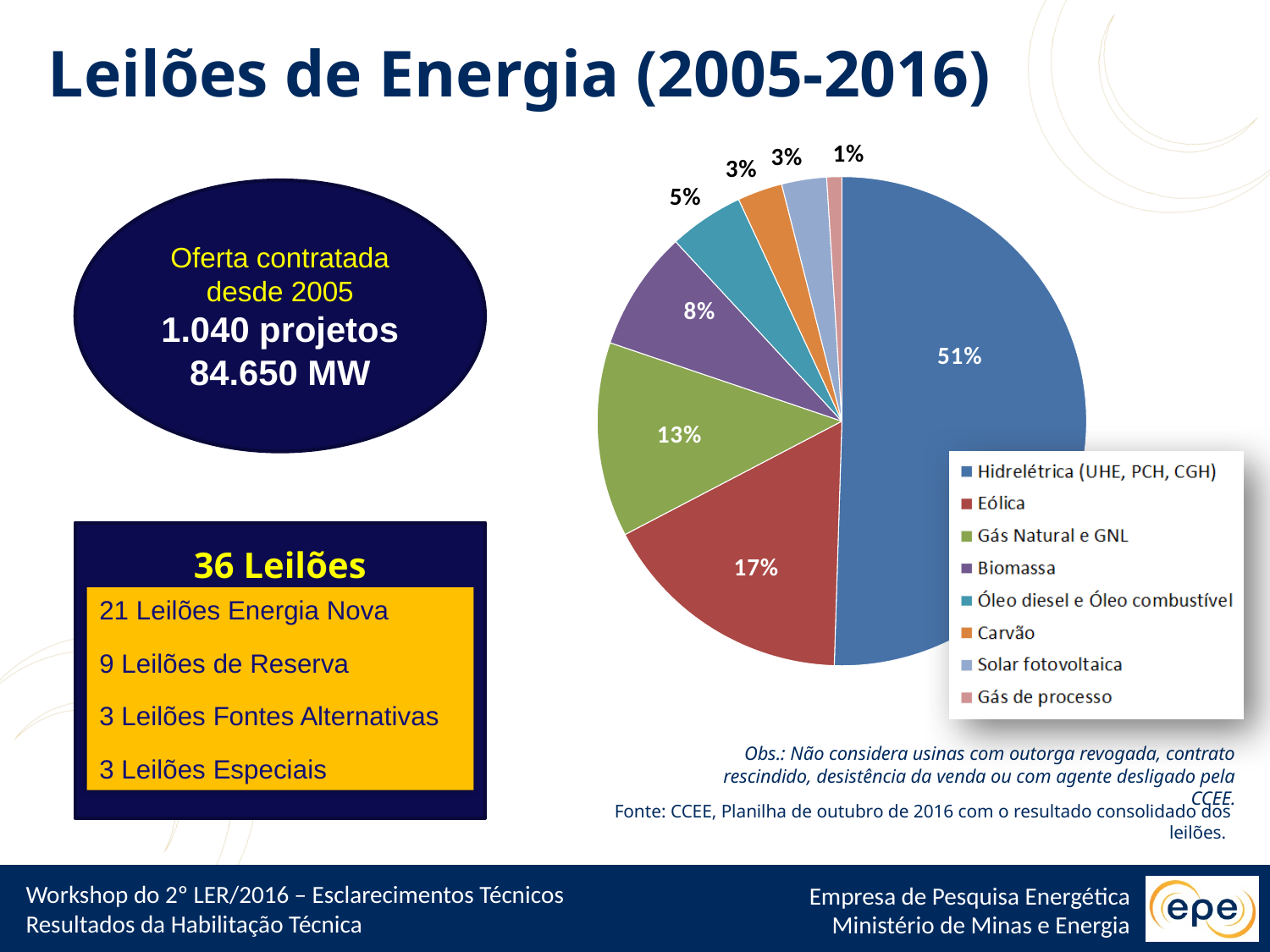
What is the difference in percentage points between Hidrelétrica (UHE, PCH, CGH) and Eólica? 34 percentage points What percentage is shown for Gás de processo? 1% What percentage is shown for Biomassa? 8% Which energy source has the largest slice of the pie? Hidrelétrica (UHE, PCH, CGH) Which energy source has the smallest slice of the pie? Gás de processo Which has a larger share, Eólica or Gás Natural e GNL? Eólica What percentage is shown for Eólica? 17% How many energy sources are listed in the pie chart legend? 8 What type of chart is shown on the slide? Pie chart What percentage is shown for Óleo diesel e Óleo combustível? 5% What percentage is shown for Gás Natural e GNL? 13% What share of the pie does Hidrelétrica (UHE, PCH, CGH) represent? 51%